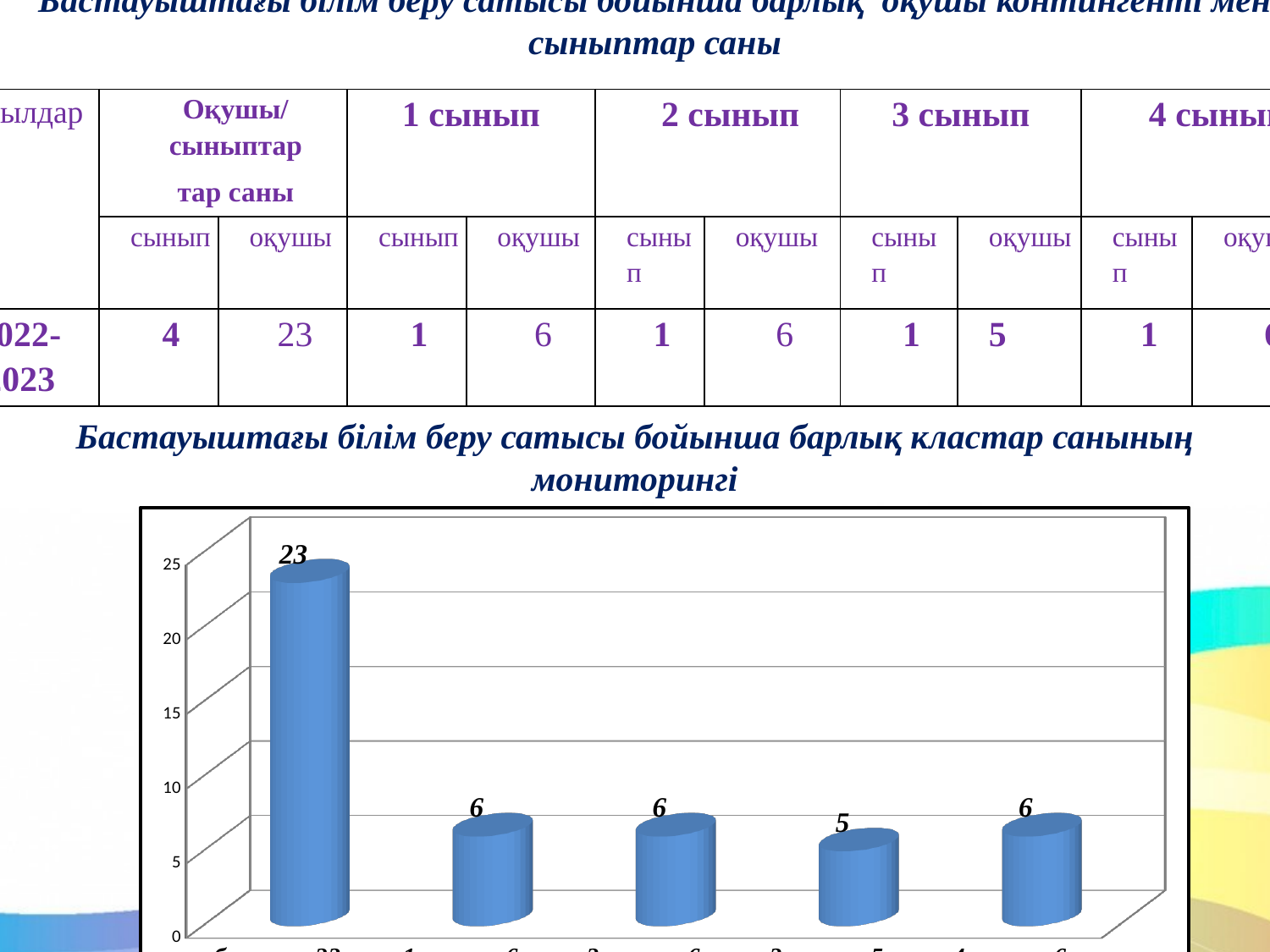
Which bar has the highest value in the chart? the first (leftmost) bar, 23 How many bars are plotted in the chart? 5 Is the value of the first bar greater or less than 20? greater What is the difference between the first bar (23) and the fourth bar (5)? 18 What is the value of the first (leftmost) bar in the chart? 23 Which is larger, the value of the third bar or the value of the fourth bar? the third bar (6) What is the value of the second bar in the chart? 6 What type of chart is shown on the slide? bar chart What is the value of the fourth bar in the chart? 5 What is the value of the fifth (rightmost) bar in the chart? 6 Which bar has the lowest value in the chart? the fourth bar, 5 What is the maximum value shown on the chart's vertical axis? 25